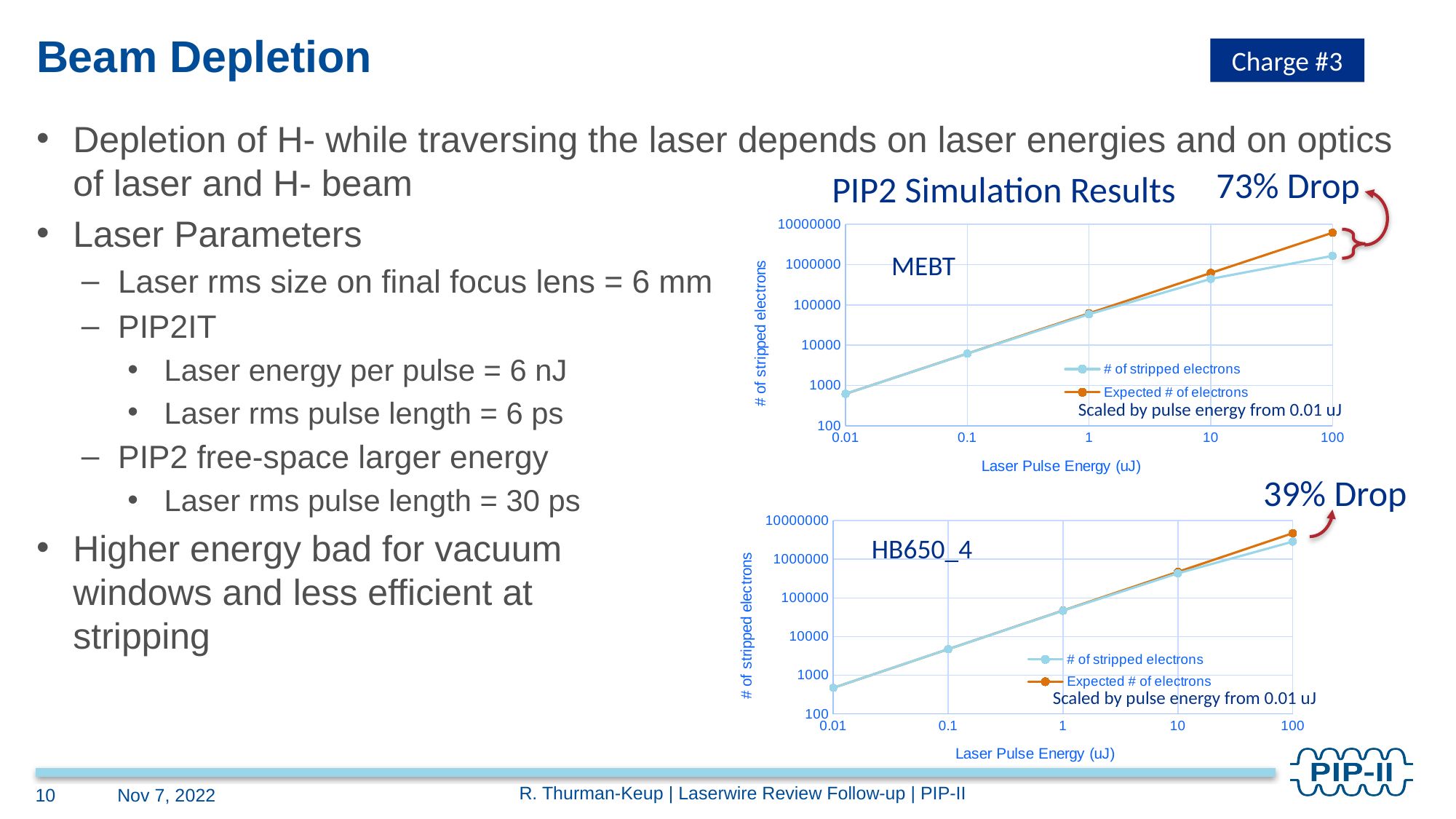
What is the x-axis label of the HB650_4 chart? Laser Pulse Energy (uJ) In the HB650_4 chart, is the '# of stripped electrons' value at 100 uJ greater or less than 1000000? greater In the MEBT chart, is the 'Expected # of electrons' value at 100 uJ greater or less than 10000000? less In the MEBT chart at 100 uJ, which series has the larger value: '# of stripped electrons' or 'Expected # of electrons'? Expected # of electrons How many data points are plotted for the '# of stripped electrons' series in the MEBT chart? 5 In the MEBT chart, does the number of stripped electrons rise or fall as laser pulse energy increases? rise In the MEBT chart, is the '# of stripped electrons' value at 100 uJ greater or less than 1000000? greater In the HB650_4 chart, does the 'Expected # of electrons' series rise or fall along the x axis? rise How many series does the legend of the HB650_4 chart list? 2 What percentage drop is annotated next to the MEBT chart? 73% Drop What type of chart is the MEBT chart? line chart